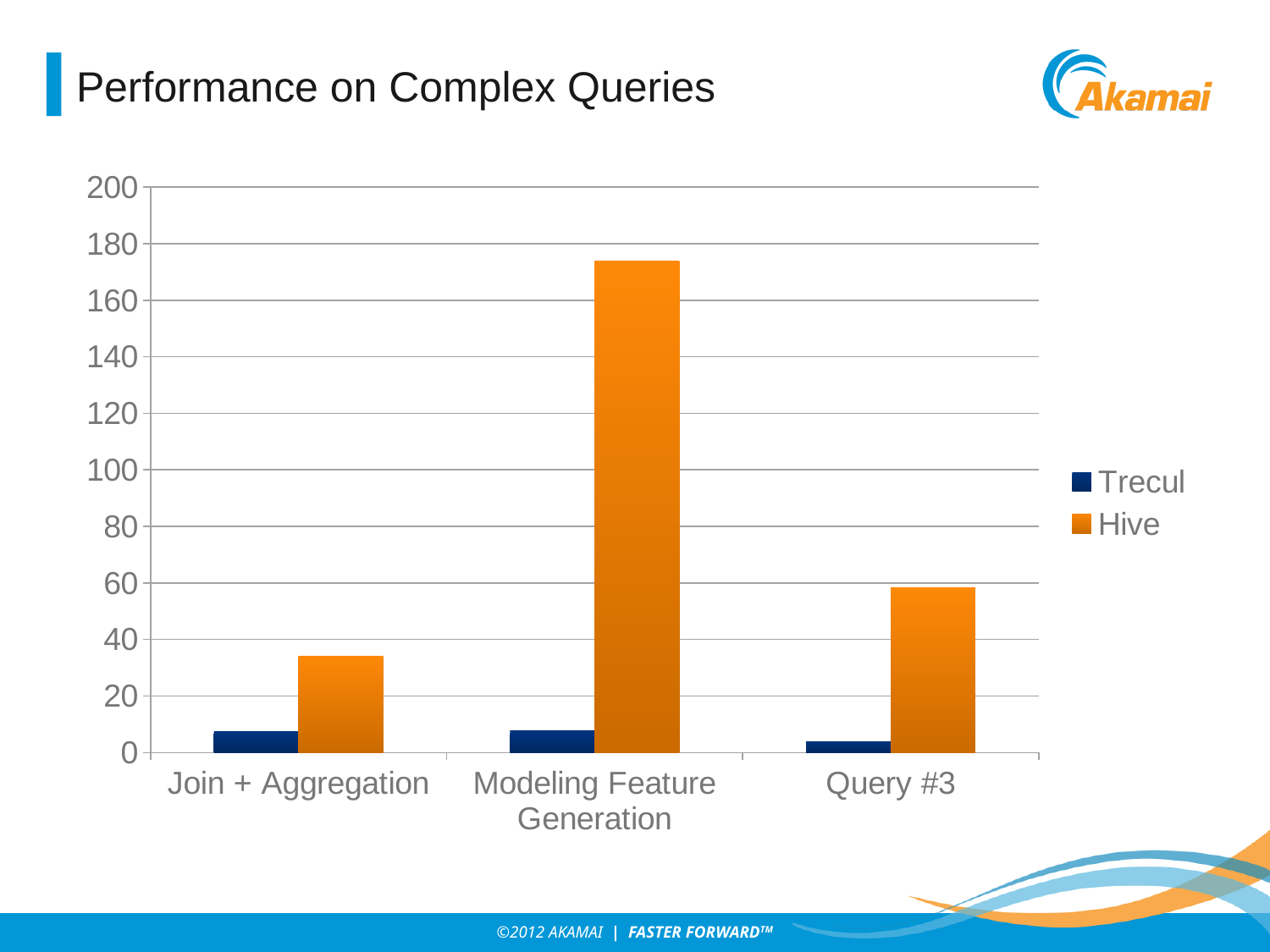
What is the title of the slide containing the chart? Performance on Complex Queries How many categories are shown on the x axis? 3 For Query #3, which series has the larger value, Trecul or Hive? Hive How many series does the legend list? 2 Is the Hive value for Query #3 greater or less than 40? greater Which category has the lowest Trecul value? Query #3 Is the Trecul value for Modeling Feature Generation greater or less than 20? less Which category has the lowest Hive value? Join + Aggregation What kind of chart is shown on the slide? bar chart Is the Hive value for Modeling Feature Generation greater or less than 160? greater Which category has the highest Hive value? Modeling Feature Generation